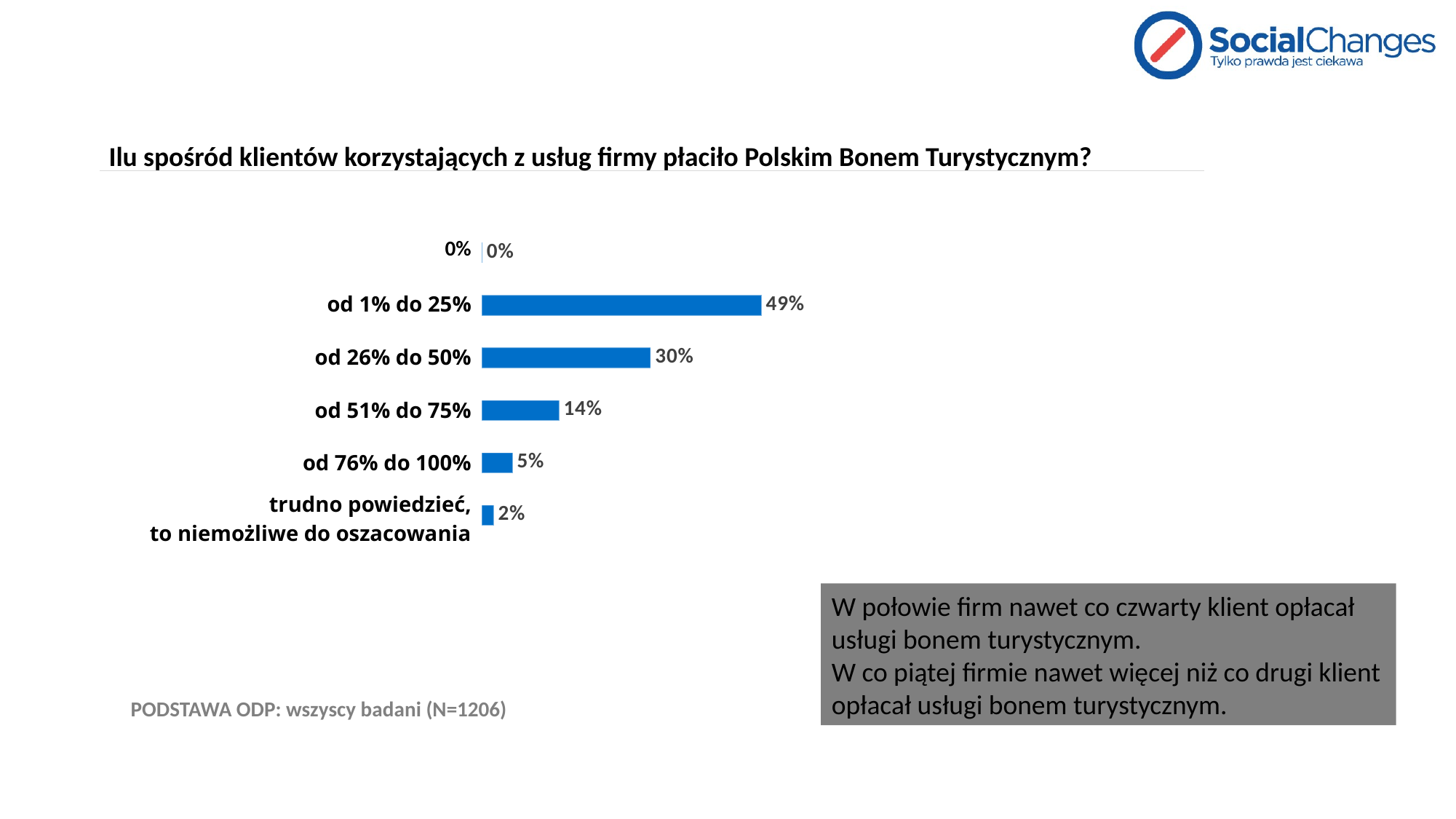
Which is larger, the value for "od 51% do 75%" or the value for "od 76% do 100%"? od 51% do 75% Which category has the lowest value? 0% What is the value for the category "od 51% do 75%"? 14% What is the value for the category "od 76% do 100%"? 5% What is the value for the category "trudno powiedzieć, to niemożliwe do oszacowania"? 2% How many categories does the chart show? 6 What is the difference between the values for "od 1% do 25%" and "od 26% do 50%"? 19% What is the title of the chart? Ilu spośród klientów korzystających z usług firmy płaciło Polskim Bonem Turystycznym? What kind of chart is shown on the slide? bar chart Which category has the highest value? od 1% do 25% What is the value for the category "od 1% do 25%"? 49% What is the value for the category "od 26% do 50%"? 30%